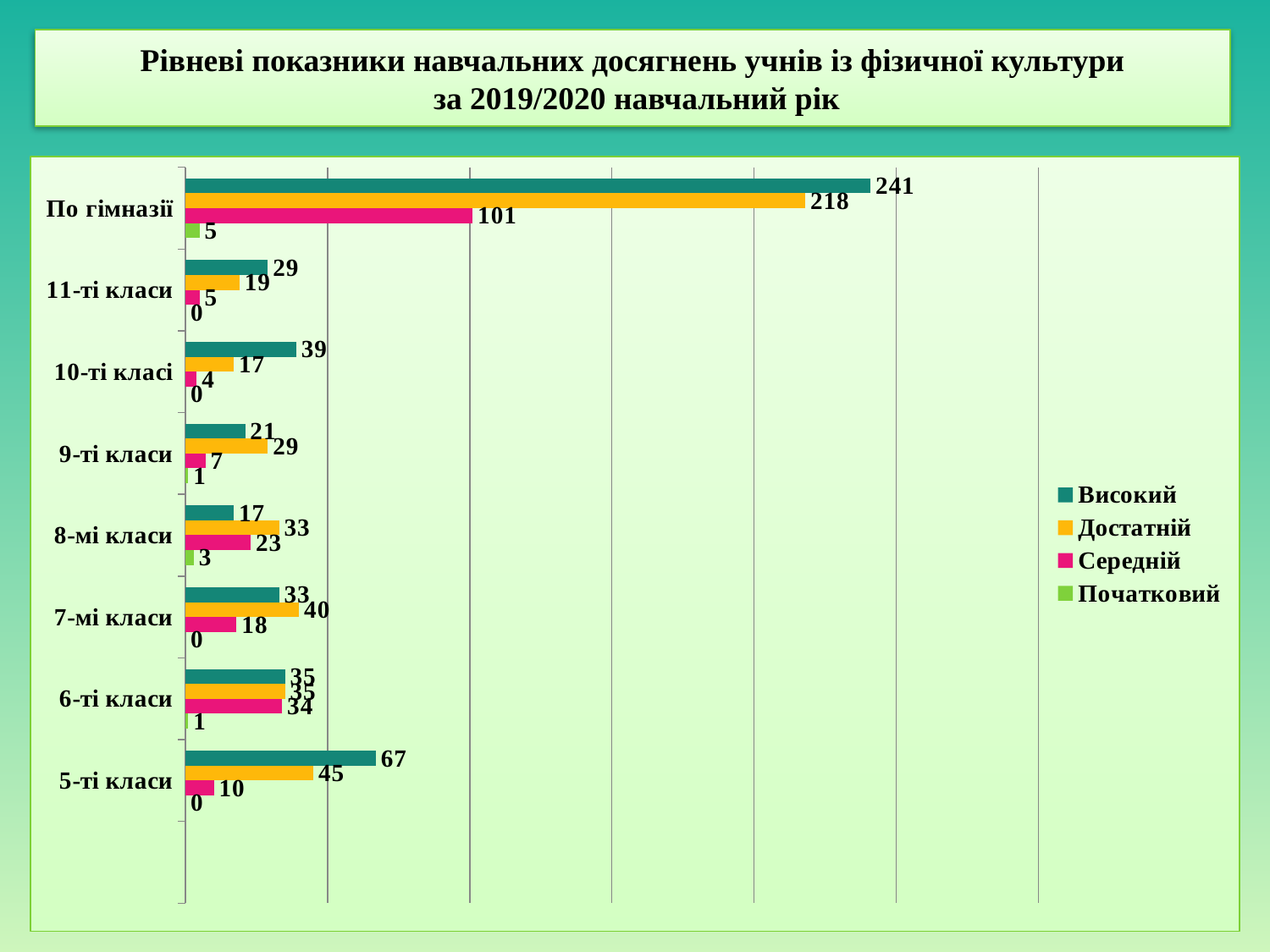
Which is larger for 9-ті класи: Високий or Достатній? Достатній What is the value of Середній for 8-мі класи? 23 What type of chart is shown on the slide? bar chart What is the value of Достатній for 7-мі класи? 40 What is the value of Високий for По гімназії? 241 Among the class categories (excluding По гімназії), which has the lowest Достатній value? 10-ті класі What is the difference between the Високий and Достатній values for По гімназії? 23 What is the value of Початковий for 9-ті класи? 1 How many categories are shown on the vertical axis? 8 Among the class categories (excluding По гімназії), which has the highest Високий value? 5-ті класи Which series is shown in pink in the legend? Середній How many series does the legend list? 4